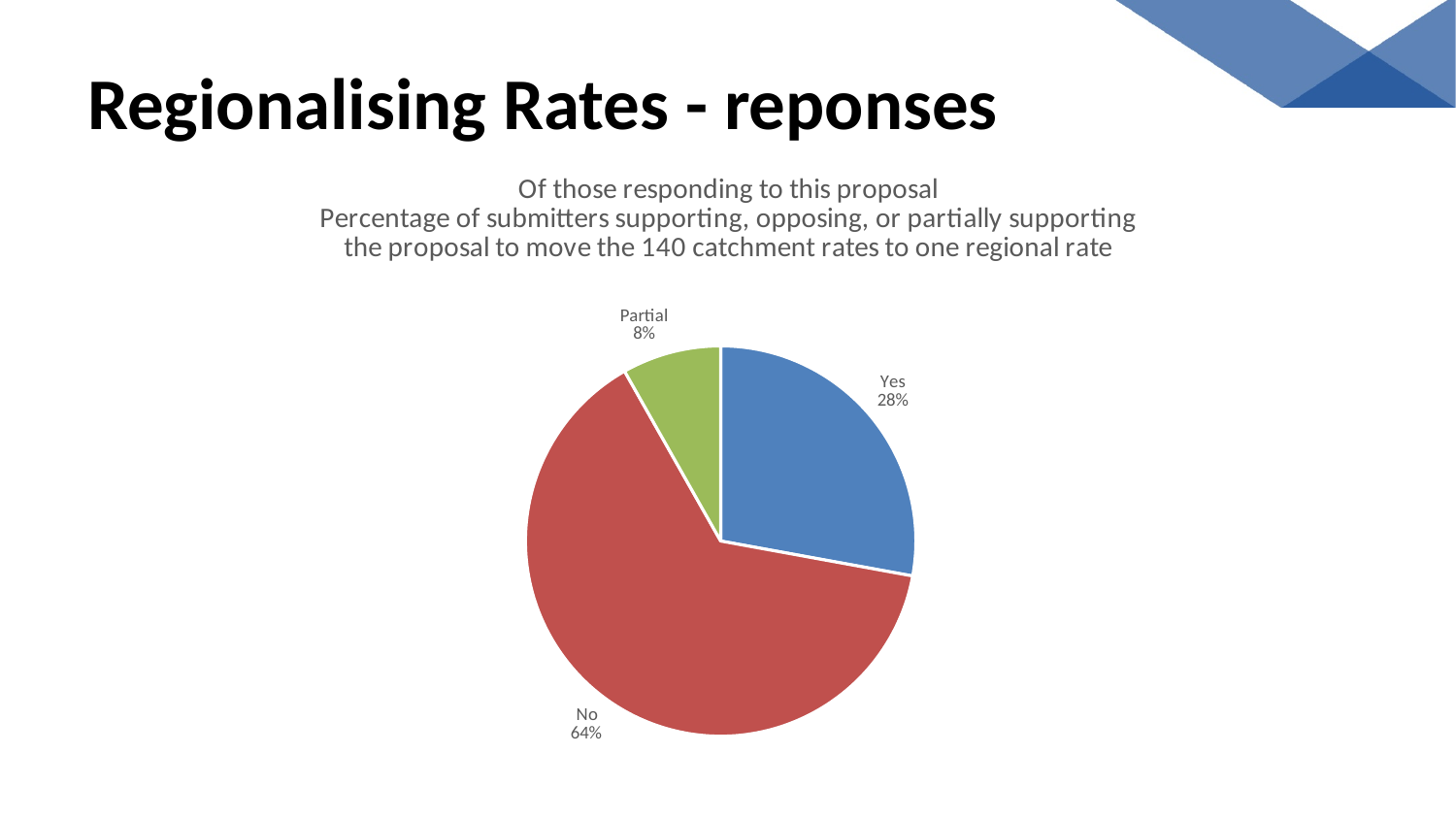
What is the difference in percentage points between the "Yes" and "Partial" shares? 20 What colour is the "No" slice of the pie chart? Red What percentage of submitters gave a "Partial" response? 8% What kind of chart is shown on the slide? Pie chart What percentage of submitters responded "No" to the proposal? 64% What share of the pie does the "No" slice represent? 64% What percentage of submitters responded "Yes" to the proposal? 28% What is the difference in percentage points between the "No" and "Yes" shares? 36 Which is larger, the "Yes" share or the "Partial" share? Yes Which response category has the smallest share of the pie? Partial Which response category has the largest share of the pie? No How many response categories are shown in the pie chart? 3